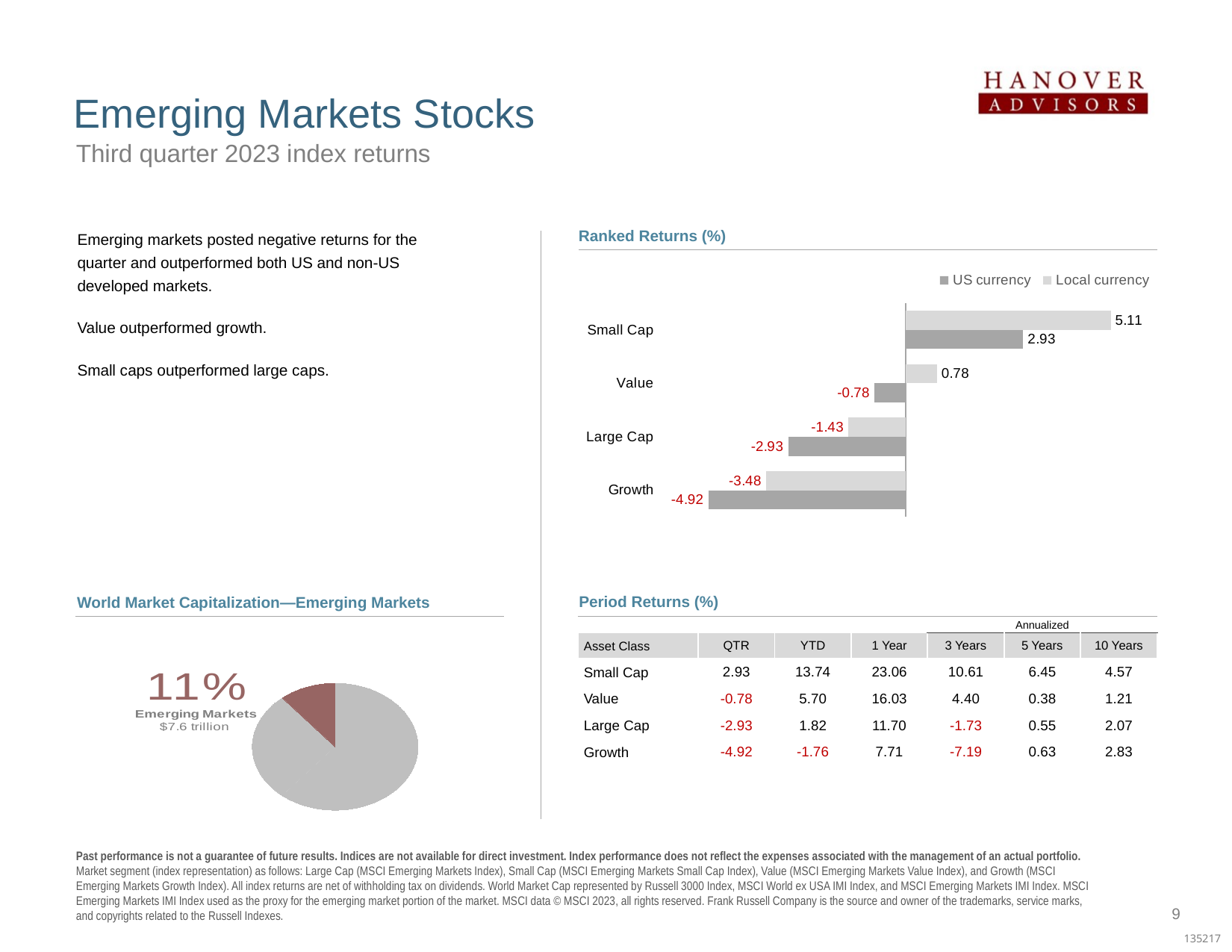
In the Ranked Returns (%) chart, which category has the highest Local currency return? Small Cap In the Ranked Returns (%) chart, which is larger for Large Cap: the US currency return or the Local currency return? Local currency In the Ranked Returns (%) chart, what is the Local currency return for Value? 0.78 In the Ranked Returns (%) chart, what is the Local currency return for Growth? -3.48 How many series does the legend of the Ranked Returns (%) chart list? 2 How many categories are shown in the Ranked Returns (%) chart? 4 In the Ranked Returns (%) chart, what is the difference between the Local currency and US currency returns for Small Cap? 2.18 In the World Market Capitalization—Emerging Markets pie chart, what dollar value is shown for Emerging Markets? $7.6 trillion What kind of chart is the Ranked Returns (%) chart? Bar chart In the World Market Capitalization—Emerging Markets pie chart, what share of world market capitalization do Emerging Markets represent? 11% In the Ranked Returns (%) chart, what is the US currency return for Small Cap? 2.93 In the Ranked Returns (%) chart, which category has the lowest US currency return? Growth